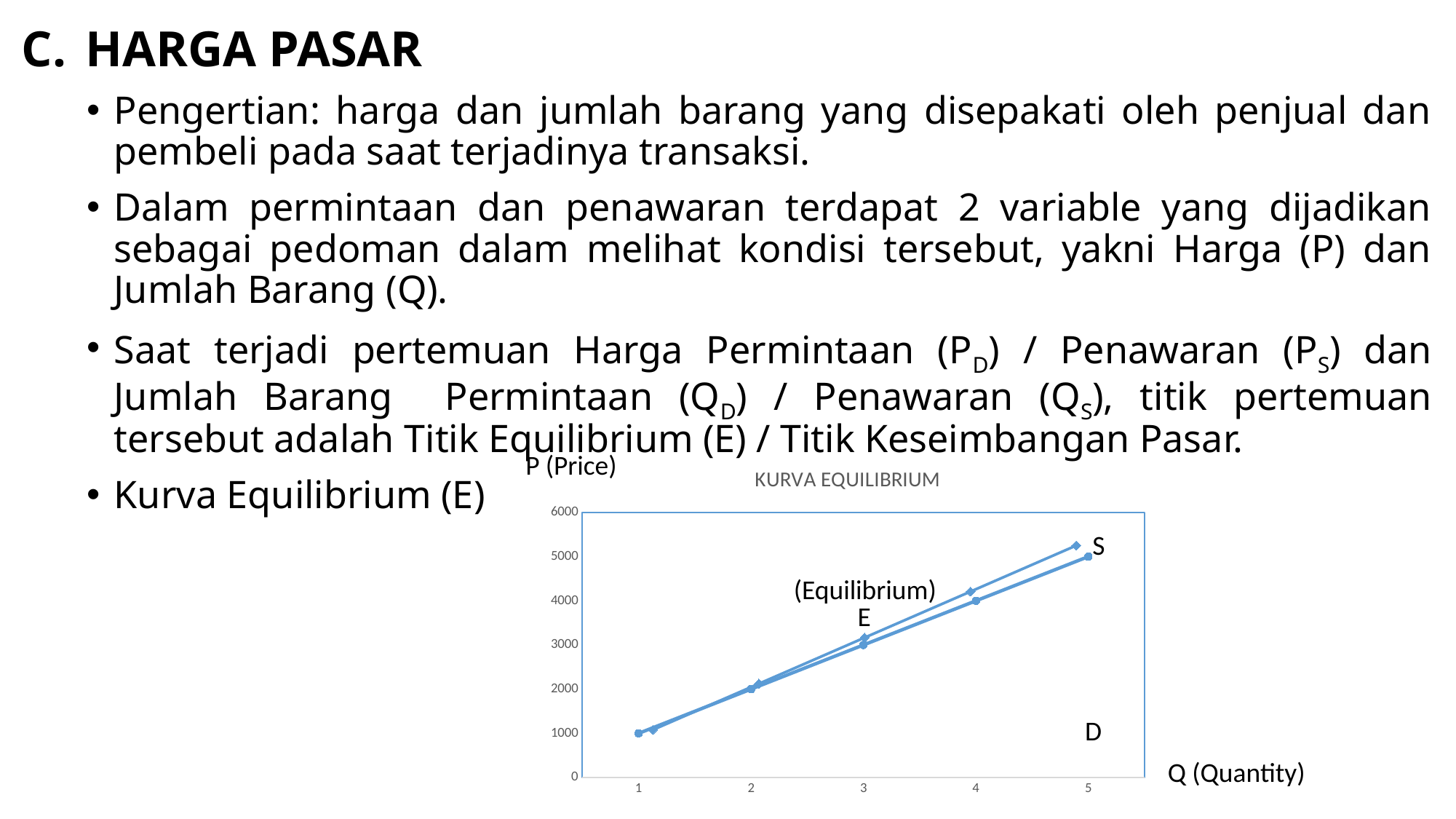
Do the plotted values rise or fall as the x axis goes from 1 to 5? rise What label is written next to the horizontal axis of the chart? Q (Quantity) Is the value at x = 5 greater or less than 4000? greater What kind of chart is shown on the slide? line chart Is the value at x = 3 greater or less than 2000? greater Which x-axis point has the highest plotted value? 5 How many points are marked along the x axis of the chart? 5 What is the title of the chart? KURVA EQUILIBRIUM Which x-axis point has the lowest plotted value? 1 Is the value at x = 1 greater or less than 2000? less